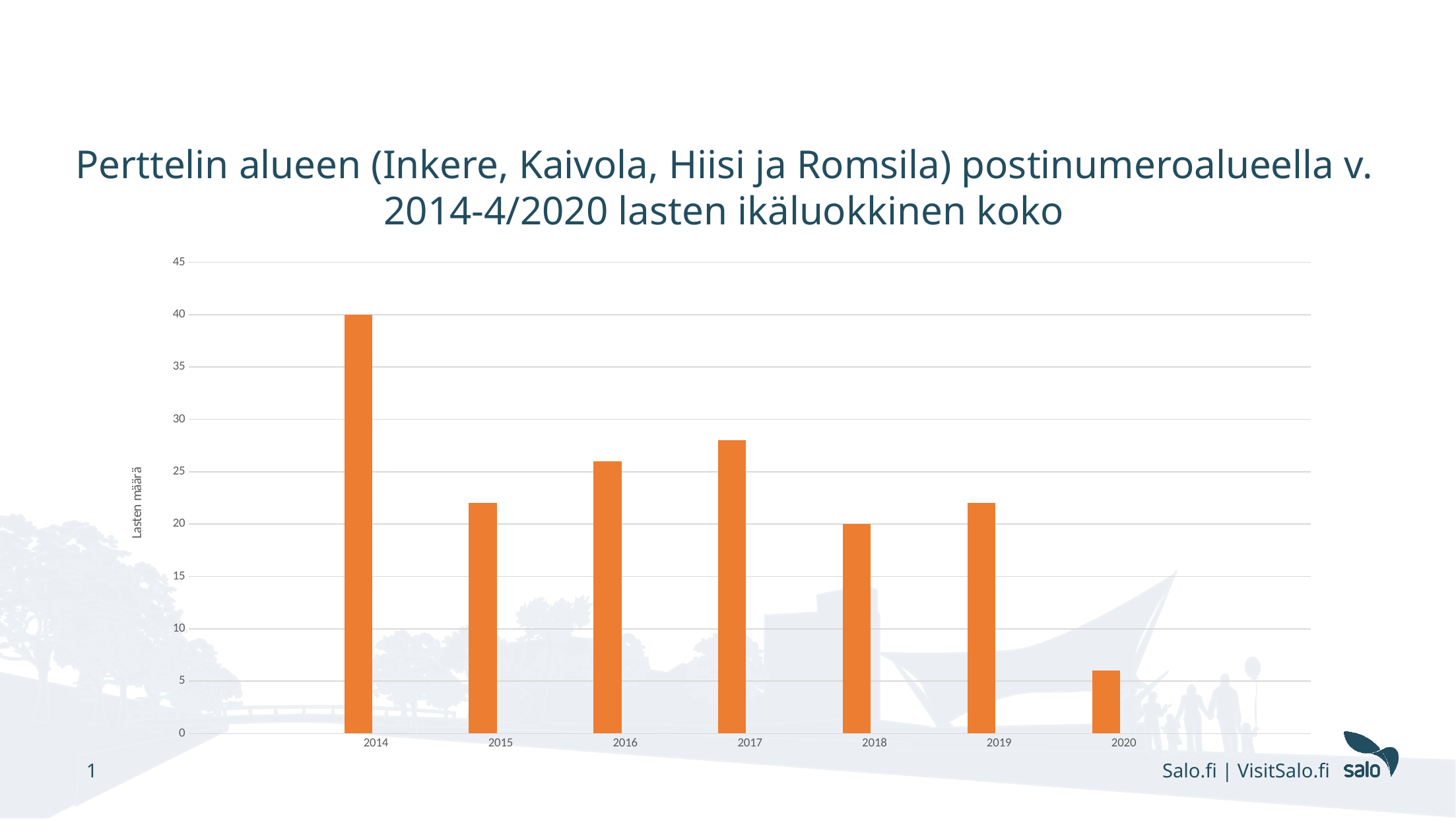
What is the difference between the values for 2014 and 2018? 20 Which year has the lowest number of children? 2020 Is the value for 2017 greater or less than 25? greater Is the value for 2020 greater or less than 10? less Is the value for 2019 greater or less than 25? less How many years are shown on the x axis of the chart? 7 What is the label of the vertical axis? Lasten määrä Which year has the highest number of children (lasten määrä)? 2014 What is the value for 2018? 20 What is the value for 2014? 40 What kind of chart is shown on the slide? bar chart Which year has the larger value, 2017 or 2015? 2017